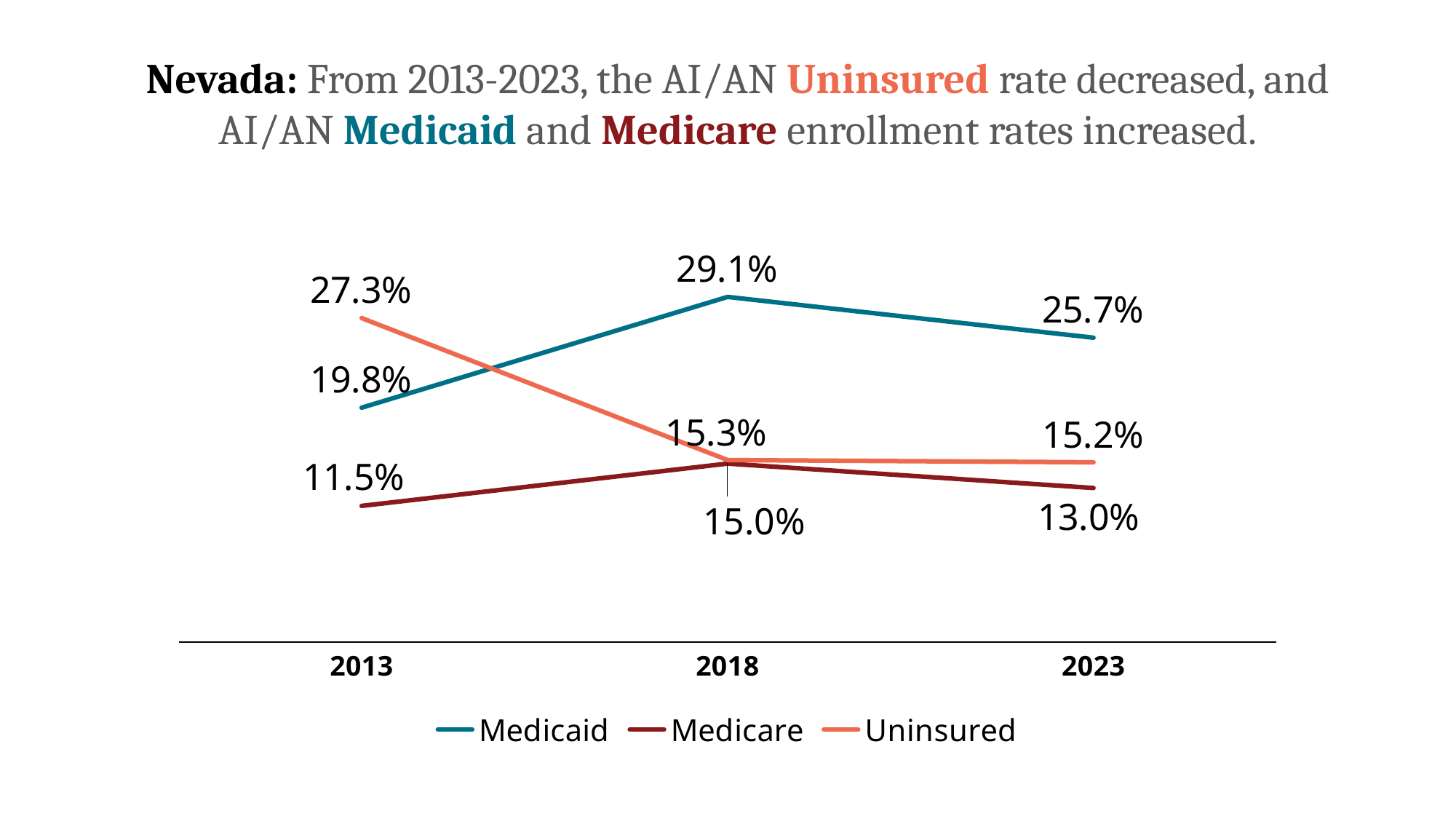
How many years are shown on the x axis? 3 In which year was the Medicare enrollment rate lowest? 2013 In which year was the Medicaid enrollment rate highest? 2018 What was the AI/AN Medicaid enrollment rate in 2018? 29.1% What was the AI/AN Uninsured rate in 2013? 27.3% How many series does the legend list? 3 What kind of chart is shown on the slide? Line chart Did the Medicare enrollment rate rise or fall from 2013 to 2018? Rise By how many percentage points did the Uninsured rate change from 2013 to 2023? 12.1 percentage points What was the AI/AN Uninsured rate in 2023? 15.2% Which was higher in 2013, the Medicaid rate or the Uninsured rate? Uninsured What was the AI/AN Medicare enrollment rate in 2023? 13.0%